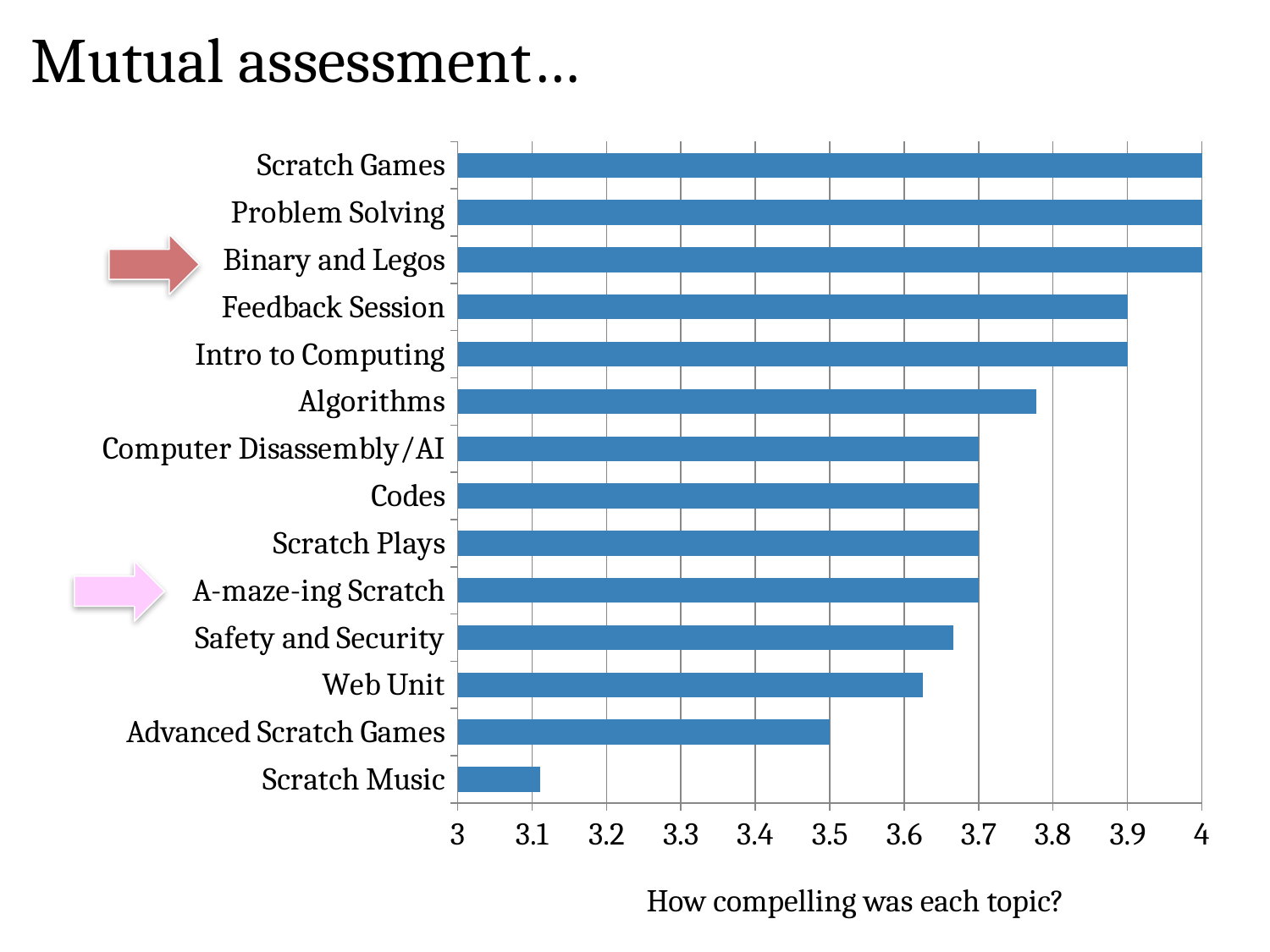
Which has a larger value, Algorithms or Codes? Algorithms What kind of chart is shown on the slide? bar chart What is the value for Codes? 3.7 What is the value for Scratch Games? 4 What is the value for Feedback Session? 3.9 What is the value for Advanced Scratch Games? 3.5 Is the value for Web Unit greater or less than 3.7? less What is the label on the horizontal axis of the chart? How compelling was each topic? Which topic has the lowest value? Scratch Music How many topics are plotted in the chart? 14 Is the value for Algorithms greater or less than 3.7? greater What is the difference between the values for Scratch Games and Advanced Scratch Games? 0.5